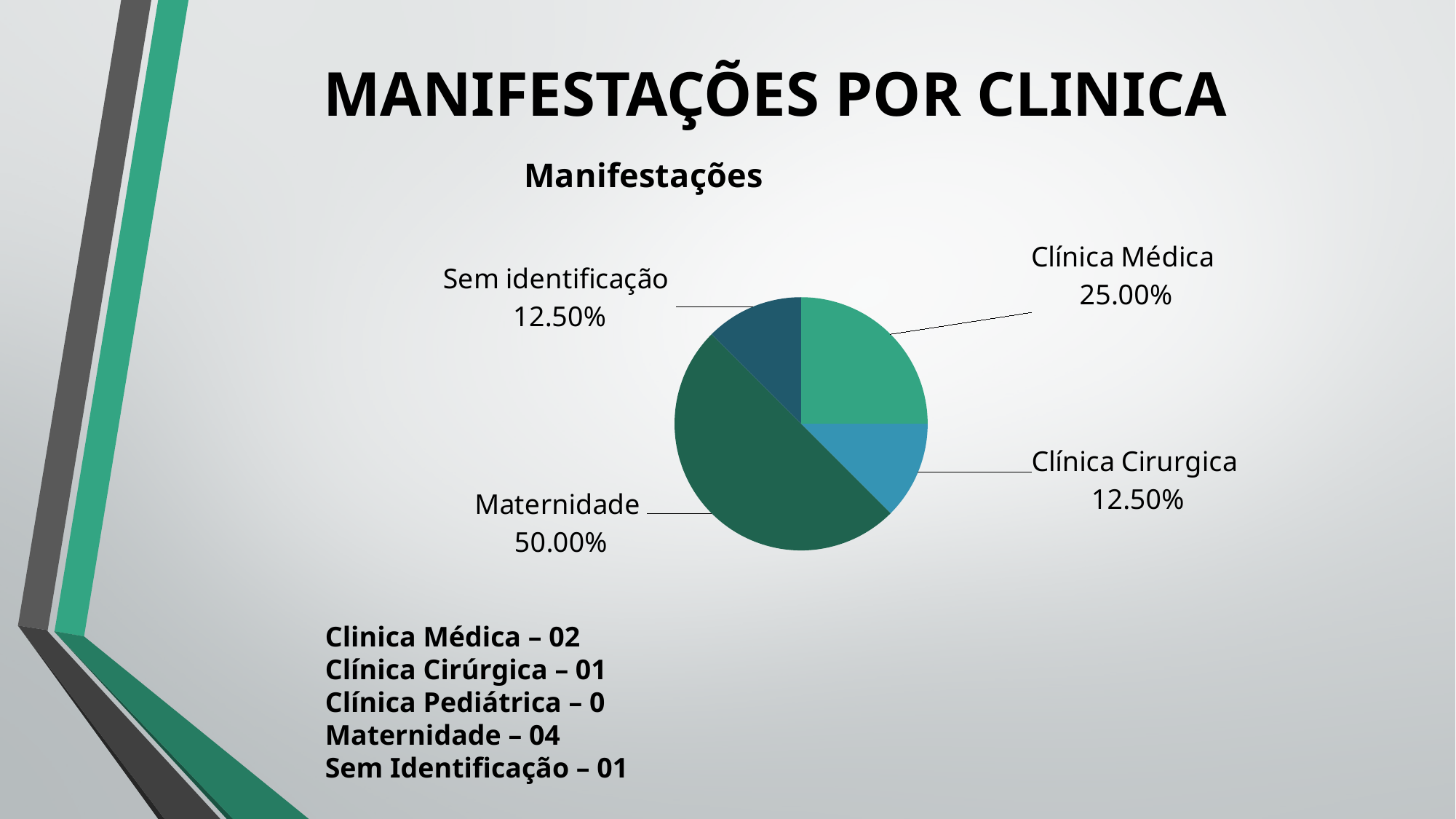
Is the share for Maternidade greater or less than 40%? greater What is the difference in percentage points between the Maternidade slice and the Clínica Médica slice? 25.00% What share of the pie does Clínica Cirurgica represent? 12.50% Which is larger, the slice for Clínica Médica or the slice for Clínica Cirurgica? Clínica Médica What share of the pie does Clínica Médica represent? 25.00% What kind of chart is shown on the slide? Pie chart What share of the pie does Maternidade represent? 50.00% Which category has the largest slice of the pie? Maternidade What is the title of the chart? Manifestações How many slices does the pie chart have? 4 What is the combined share of Clínica Cirurgica and Sem identificação? 25.00%